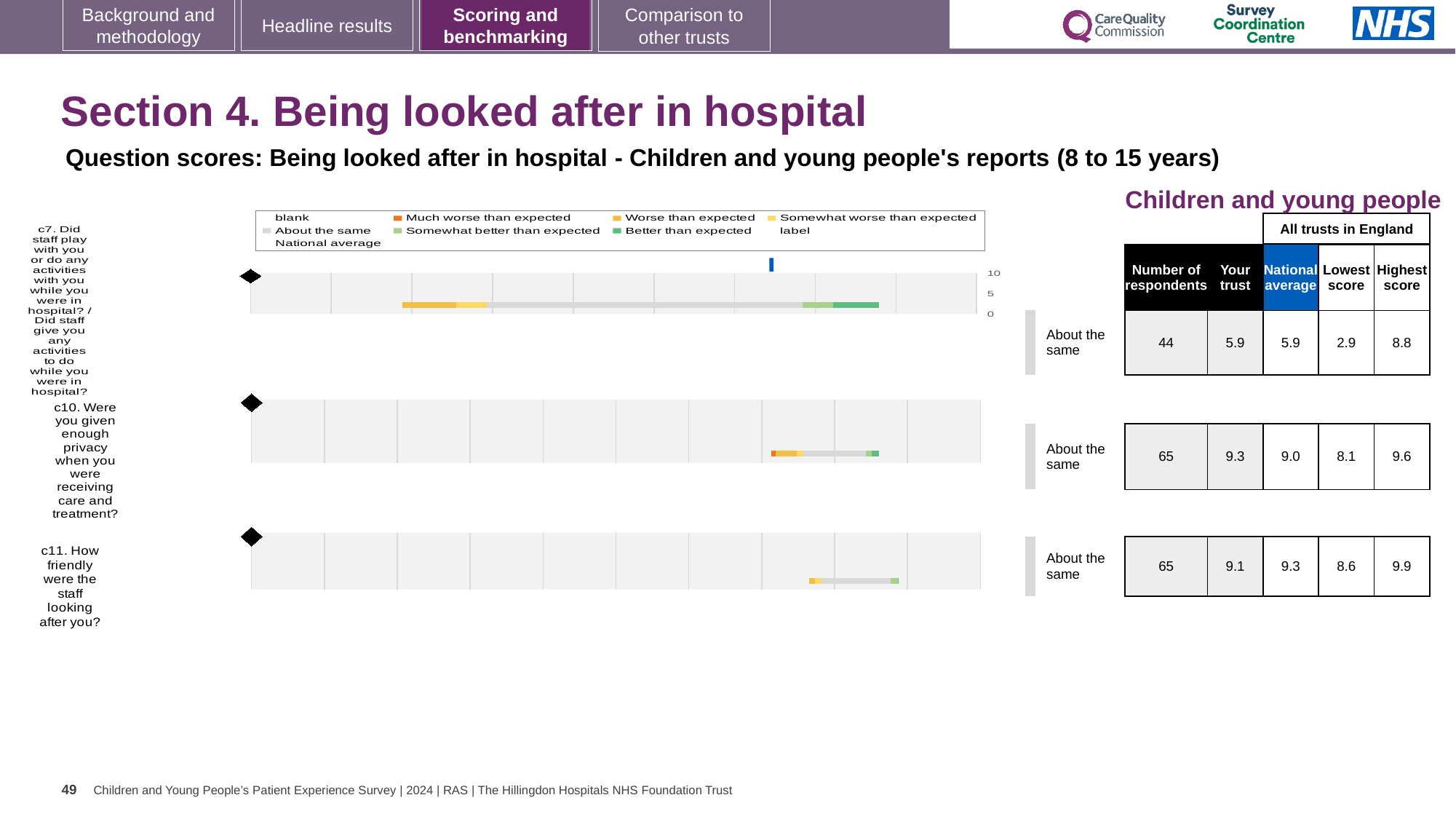
What benchmark category is shown for c7? About the same Which question has the highest 'Your trust' score? c10. Were you given enough privacy when you were receiving care and treatment? What is the highest score across all trusts in England for c7? 8.8 Which question has the lowest national average score? c7. Did staff play with you or do any activities with you while you were in hospital? How many respondents answered c7 (Did staff play with you or do any activities with you while you were in hospital?)? 44 For c10, which is larger: the 'Your trust' score or the national average? Your trust How many questions are charted on this slide? 3 What is the national average score for c11 (How friendly were the staff looking after you?)? 9.3 What is the lowest score across all trusts in England for c10? 8.1 What is the difference between the national average and the 'Your trust' score for c11? 0.2 What is the 'Your trust' score for c10 (Were you given enough privacy when you were receiving care and treatment?)? 9.3 What kind of chart is used to show the question scores? Bar chart